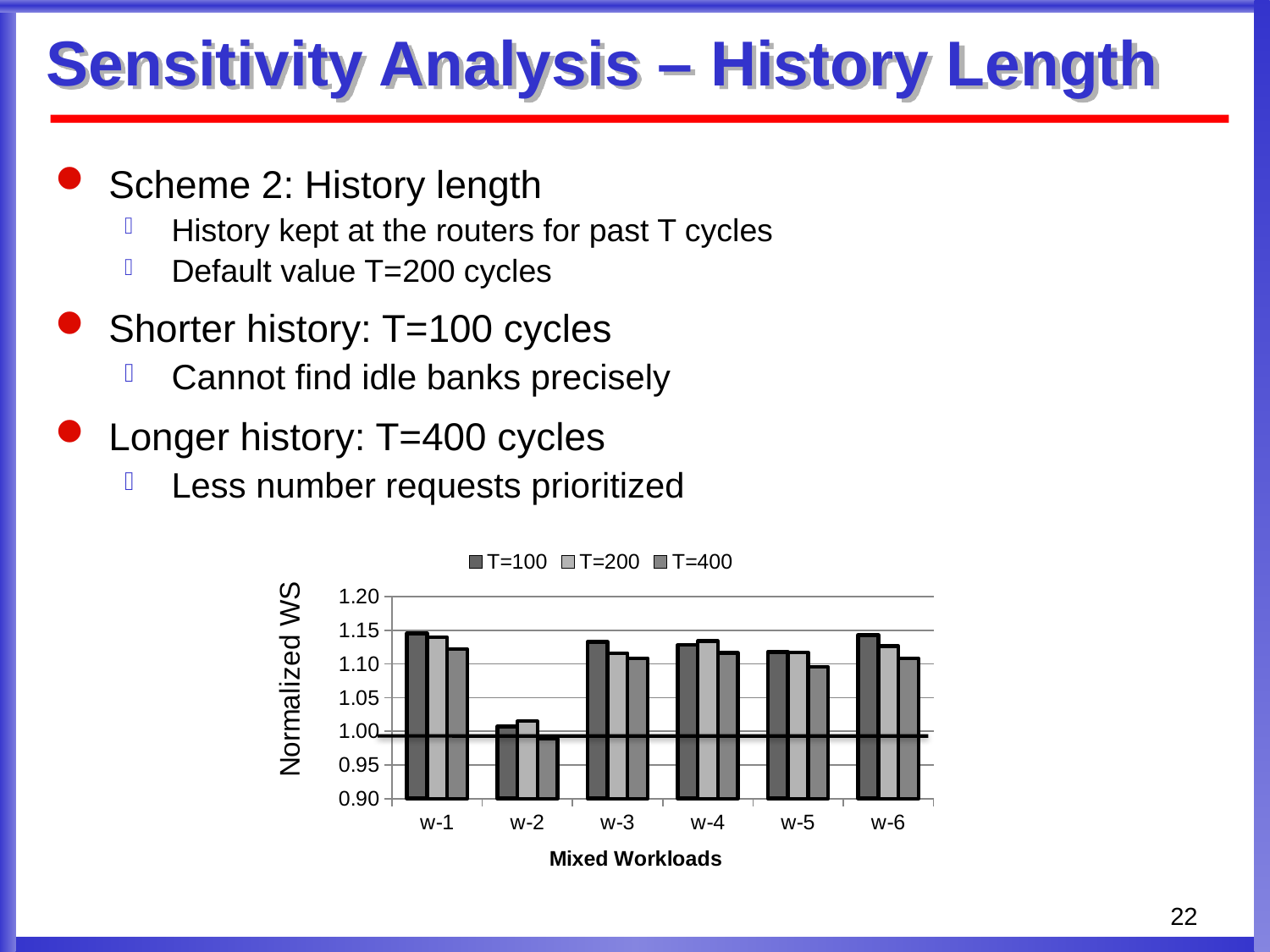
Is the T=200 value for w-4 greater or less than 1.10? greater How many mixed workloads are shown on the x axis? 6 Is the T=100 value for w-1 greater or less than 1.10? greater How many series does the legend list? 3 Is the T=400 value for w-2 greater or less than 1.00? less What is the label of the x axis? Mixed Workloads What kind of chart is shown on the slide? bar chart For w-5, which is larger: the T=100 value or the T=400 value? T=100 What is the label of the y axis? Normalized WS Which workload has the lowest Normalized WS values across all three history lengths? w-2 For w-2, which is larger: the T=200 value or the T=400 value? T=200